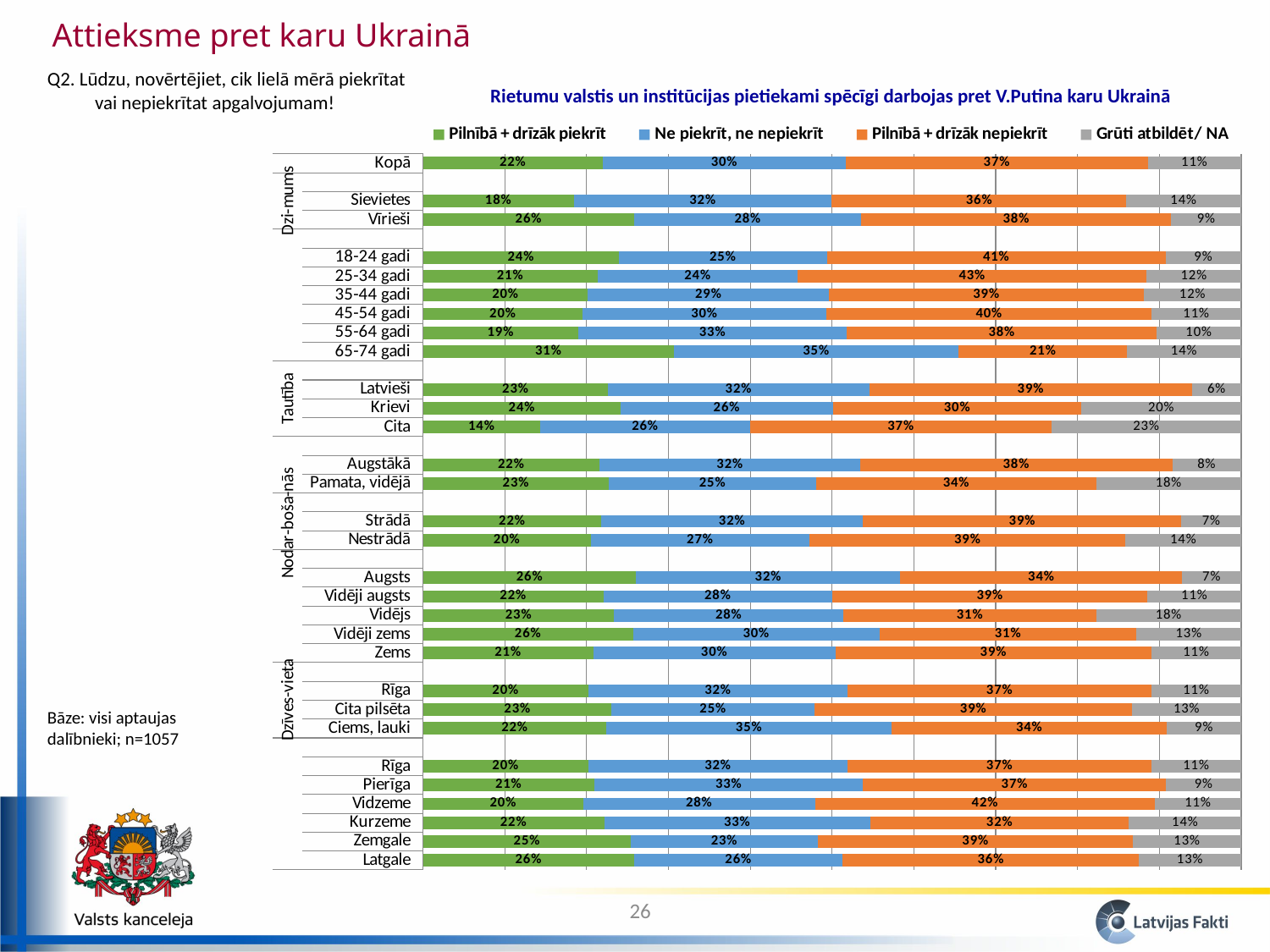
Which category has the highest value for "Pilnībā + drīzāk nepiekrīt"? 25-34 gadi What kind of chart is shown on the slide? Stacked bar chart What is the value of "Grūti atbildēt/ NA" for Krievi? 20% What is the value of "Pilnībā + drīzāk nepiekrīt" for Kopā? 37% What is the value of "Pilnībā + drīzāk piekrīt" for 65-74 gadi? 31% Which colour represents the "Pilnībā + drīzāk piekrīt" series? Green What is the title of the chart? Rietumu valstis un institūcijas pietiekami spēcīgi darbojas pret V.Putina karu Ukrainā Which is larger: the "Pilnībā + drīzāk nepiekrīt" value for Vidzeme or for Kurzeme? Vidzeme What is the value of "Ne piekrīt, ne nepiekrīt" for Ciems, lauki? 35% What is the difference between the "Pilnībā + drīzāk piekrīt" values for Vīrieši and Sievietes? 8% Which category has the lowest value for "Grūti atbildēt/ NA"? Latvieši How many series does the legend list? 4